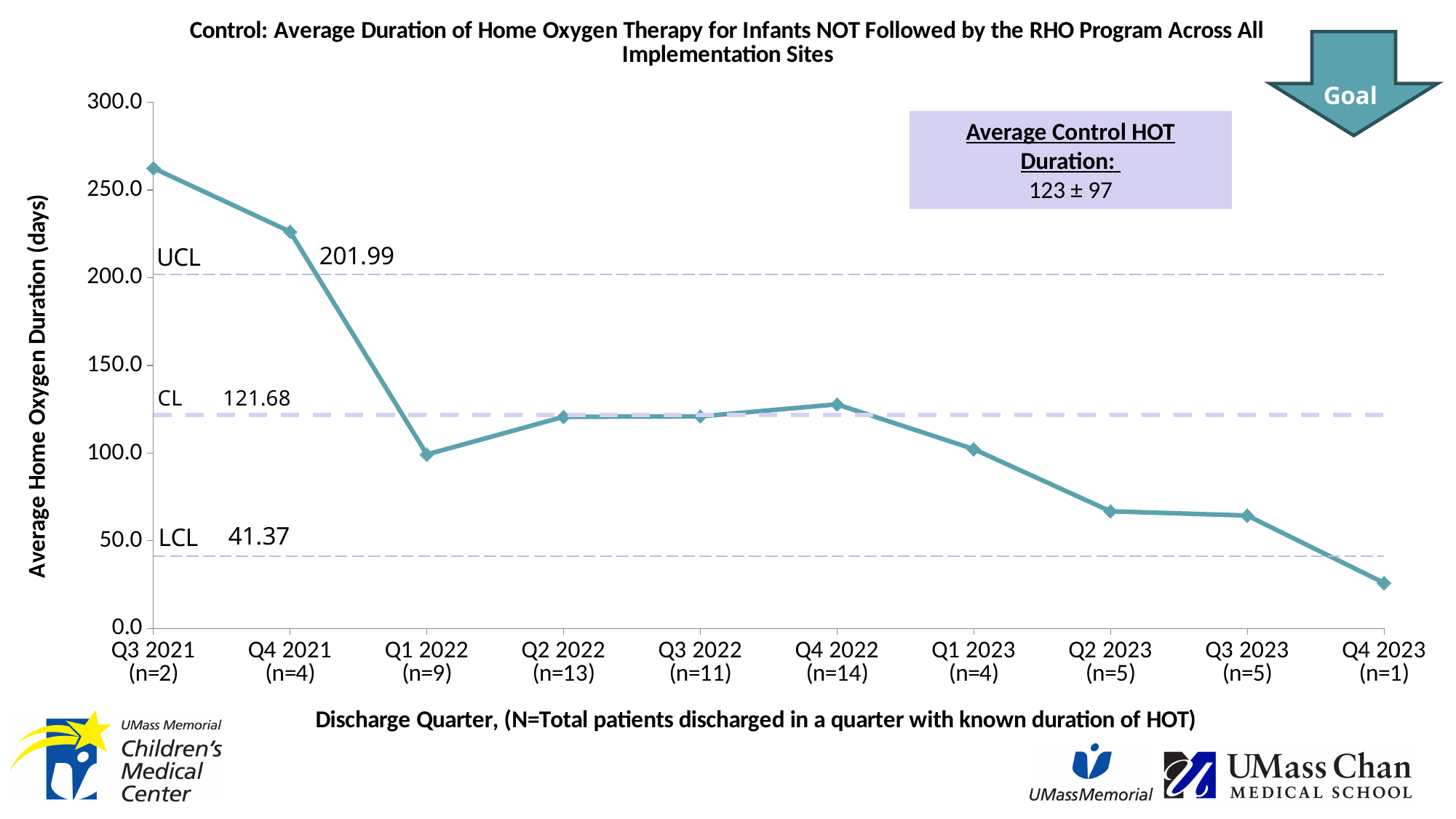
What kind of chart is shown on the slide? line chart Is the value for Q4 2023 greater or less than 50? less Which discharge quarter has the lowest average home oxygen duration? Q4 2023 Is the value for Q3 2021 greater or less than 250? greater What is the value of the CL line? 121.68 What is the value of the LCL line? 41.37 What is the value of the UCL line? 201.99 Which is larger, the value for Q4 2022 or the value for Q1 2023? Q4 2022 Which discharge quarter has the highest average home oxygen duration? Q3 2021 Overall, do the values rise or fall from Q3 2021 to Q4 2023? fall How many discharge quarters are plotted on the x axis? 10 Is the value for Q2 2023 greater or less than 100? less